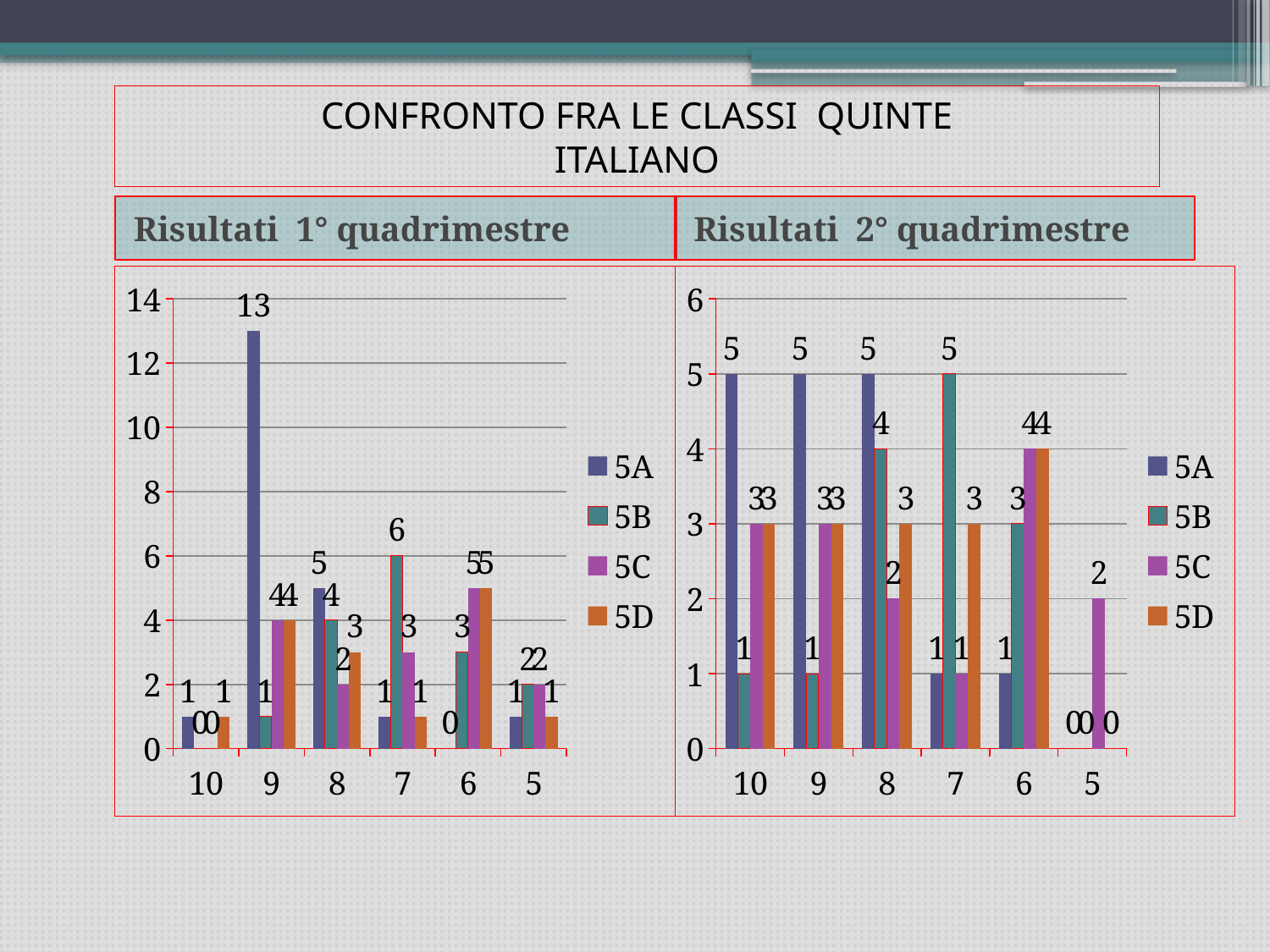
How many series does the legend of the 'Risultati 2° quadrimestre' chart list? 4 In the 'Risultati 1° quadrimestre' chart, which series has the highest value at category 8? 5A In the 'Risultati 2° quadrimestre' chart, what is the difference between 5C and 5B at category 6? 1 In the 'Risultati 2° quadrimestre' chart, what is the value for 5C at category 5? 2 In the 'Risultati 2° quadrimestre' chart, is the value for 5A at category 10 larger or smaller than the value for 5B at category 10? larger In the 'Risultati 1° quadrimestre' chart, what is the value for 5A at category 9? 13 In the 'Risultati 1° quadrimestre' chart, what is the value for 5B at category 7? 6 In the 'Risultati 1° quadrimestre' chart, what is the difference between 5A and 5B at category 9? 12 In the 'Risultati 1° quadrimestre' chart, how many categories are shown on the x axis? 6 In the 'Risultati 2° quadrimestre' chart, which series has the lowest value at category 8? 5C What type of chart is the 'Risultati 1° quadrimestre' chart? bar chart In the 'Risultati 2° quadrimestre' chart, what is the value for 5B at category 7? 5